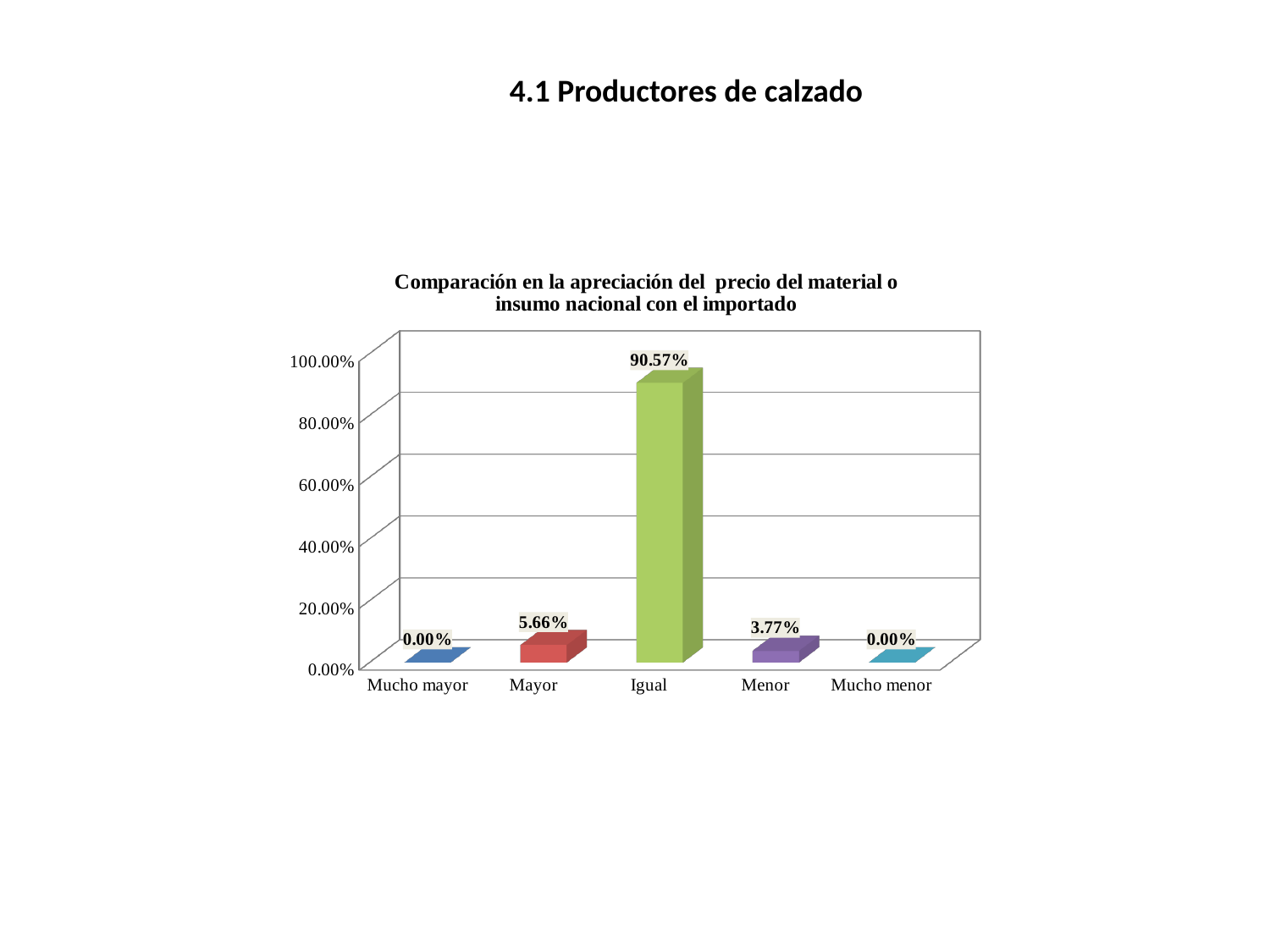
What is the value for Mucho mayor? 0.00% What kind of chart is shown on the slide? bar chart What is the title of the chart? Comparación en la apreciación del precio del material o insumo nacional con el importado What is the difference between the values for Igual and Mayor? 84.91% What is the value for Igual? 90.57% Is the value for Igual greater or less than 80.00%? greater What is the value for Menor? 3.77% How many categories are shown on the x axis? 5 Which category has the highest value? Igual Which is larger, the value for Mayor or the value for Menor? Mayor What is the value for Mayor? 5.66% What is the difference between the values for Mayor and Menor? 1.89%